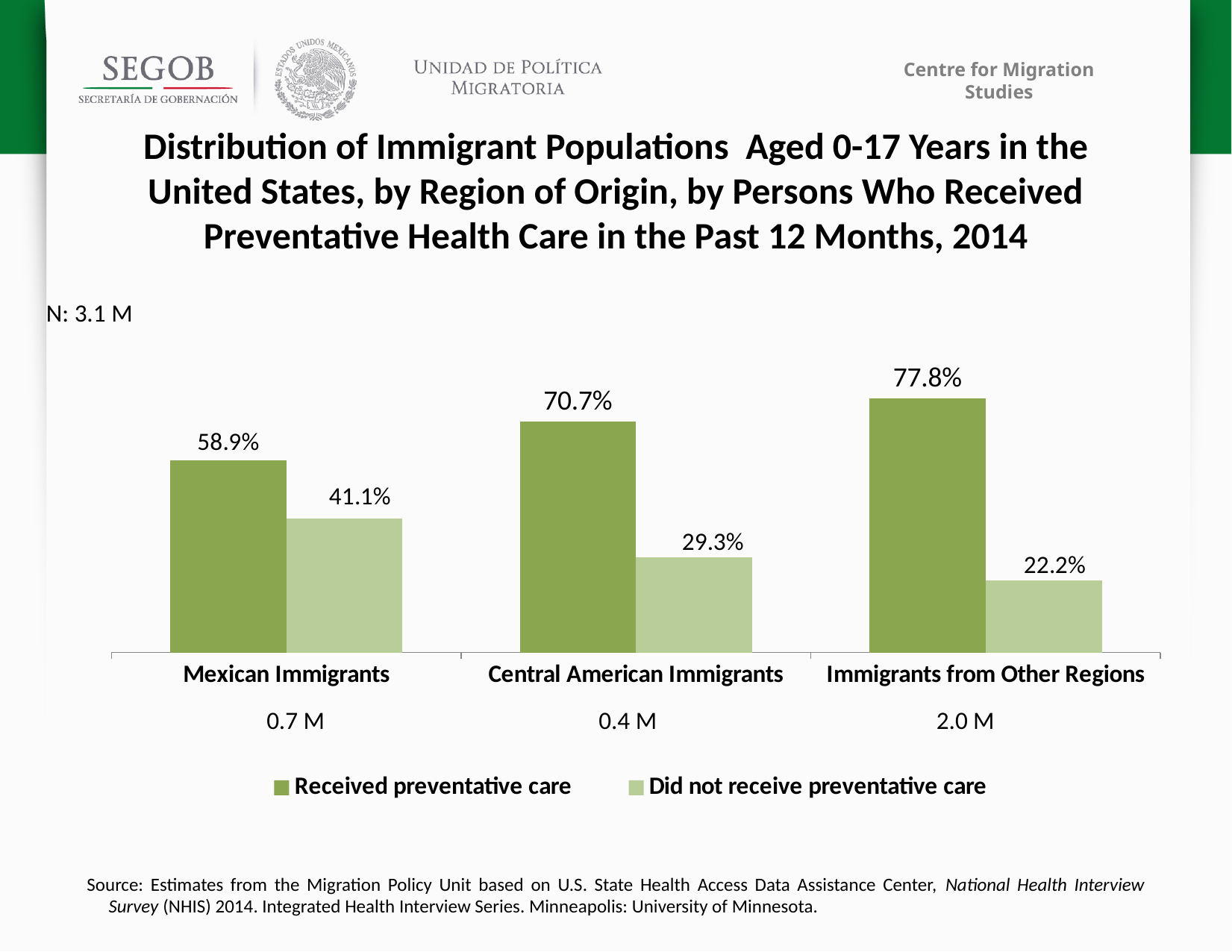
Which region of origin has the highest share of children who received preventative care? Immigrants from Other Regions What is the population size (N) shown for the chart? 3.1 M What percentage of Mexican immigrants aged 0-17 received preventative care? 58.9% How many regions of origin are shown on the x axis? 3 How many series does the legend list? 2 Which is larger: the share of Mexican immigrants who did not receive preventative care or the share of Central American immigrants who did not receive preventative care? Mexican Immigrants Which region of origin has the lowest share of children who did not receive preventative care? Immigrants from Other Regions What percentage of immigrants from other regions aged 0-17 received preventative care? 77.8% What population size is shown below the Central American Immigrants category? 0.4 M What percentage of Central American immigrants aged 0-17 did not receive preventative care? 29.3% What is the difference between the share of Central American immigrants who received preventative care and the share who did not? 41.4% What kind of chart is shown on the slide? Bar chart